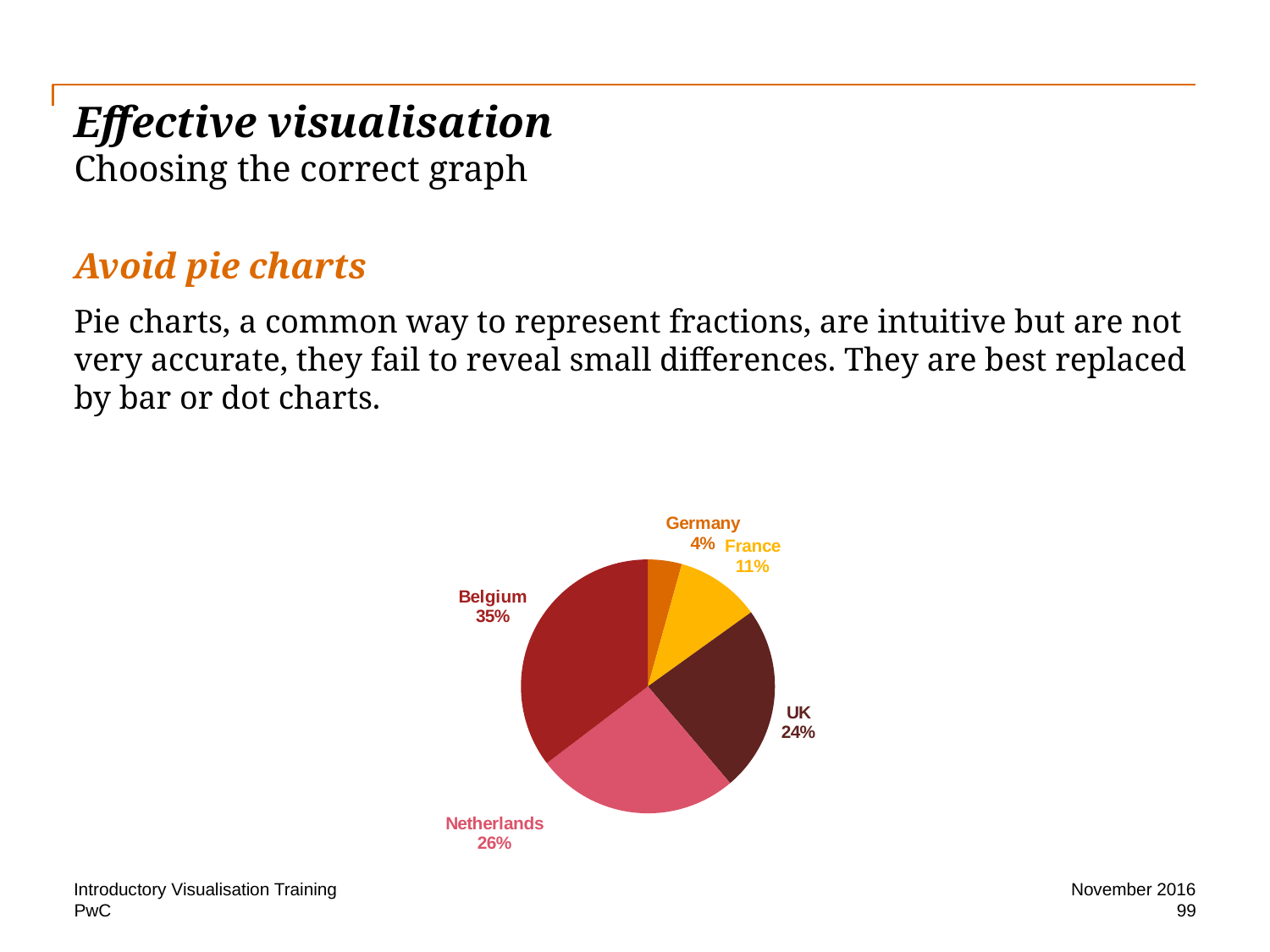
What is the value shown for France? 11% Which country has the largest slice of the pie? Belgium What is the value shown for Germany? 4% What is the value shown for the UK slice? 24% What colour is the Belgium slice of the pie? Dark red What share of the pie does Belgium have? 35% Which country has the smallest slice of the pie? Germany What is the difference in percentage points between Belgium and the UK? 11 Which is larger, the Netherlands slice or the France slice? Netherlands What is the difference in percentage points between the Netherlands and Germany? 22 How many slices does the pie chart have? 5 What kind of chart is shown on the slide? Pie chart